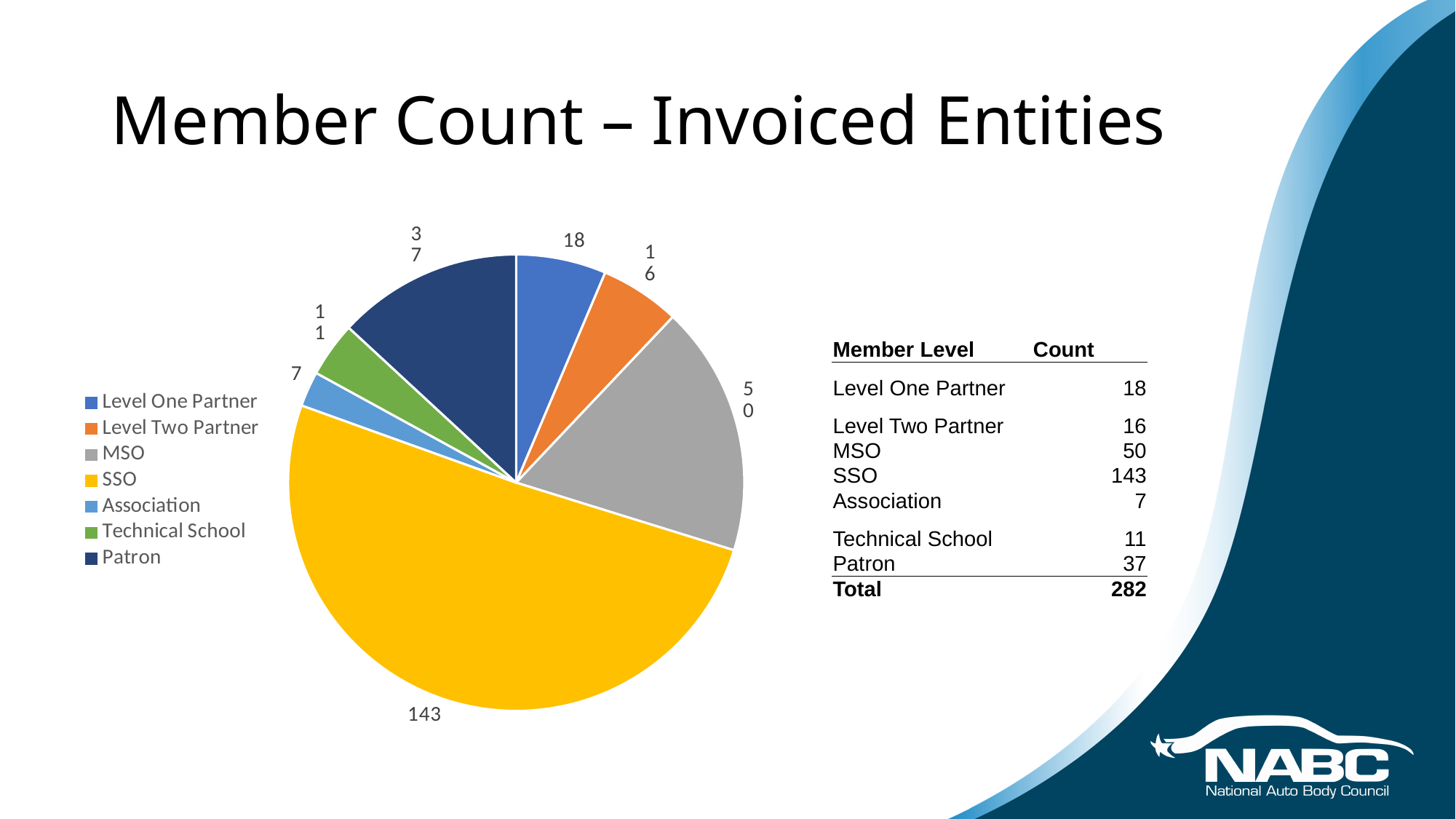
What is the difference between the values for Patron and Level One Partner? 19 What is the value for Patron in the pie chart? 37 Which category has the largest slice in the pie chart? SSO Which category has the smallest slice in the pie chart? Association What is the value for Technical School in the pie chart? 11 What colour is the SSO slice in the pie chart? yellow How many categories are shown in the pie chart? 7 Which is larger, the value for MSO or the value for Patron? MSO What type of chart is shown on the slide? pie chart What is the difference between the values for SSO and MSO? 93 What is the value for Level Two Partner in the pie chart? 16 What is the value for SSO in the pie chart? 143